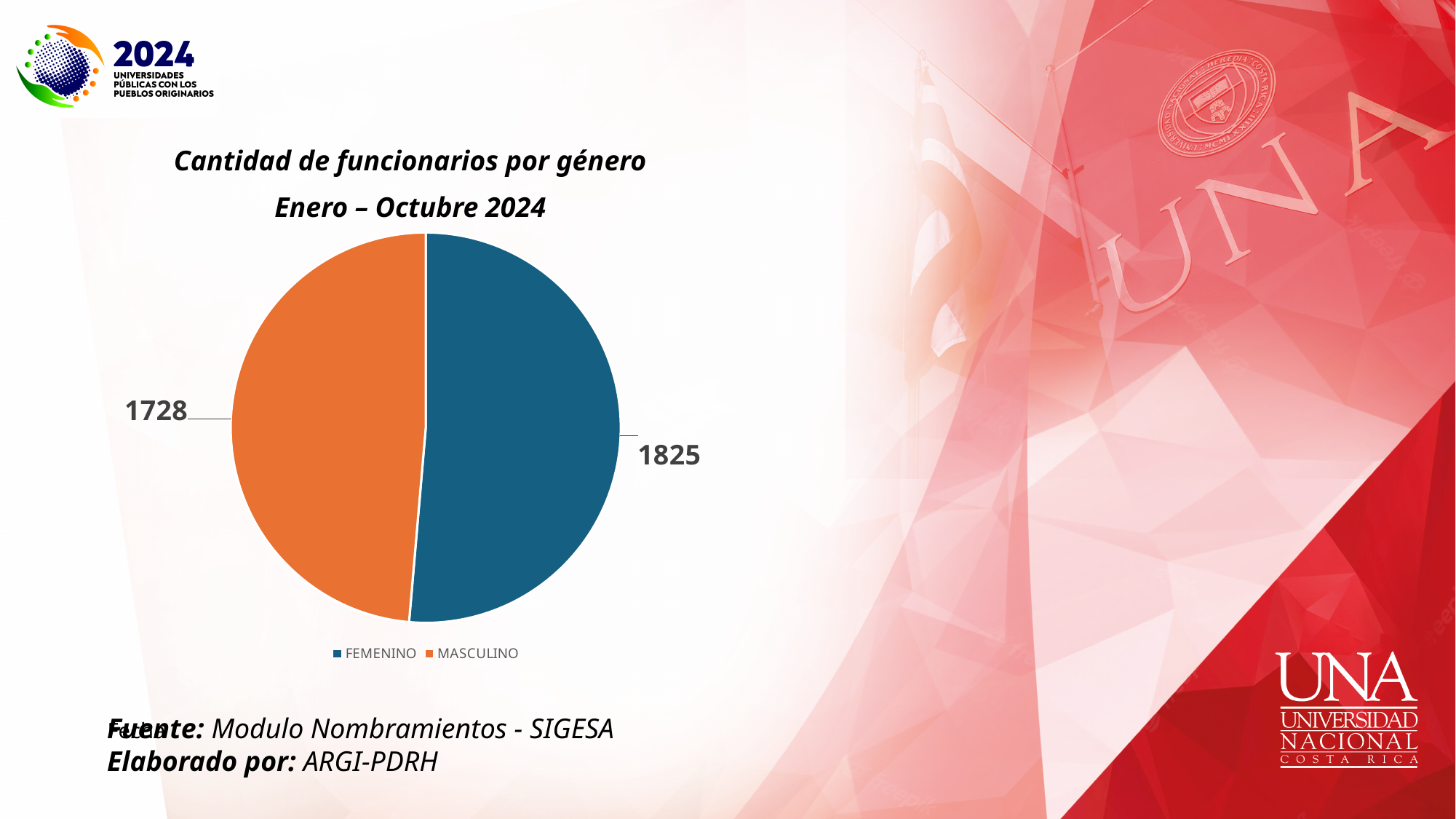
Which category has the largest slice in the pie chart? FEMENINO How many entries does the legend of the pie chart list? 2 What colour is the FEMENINO slice in the pie chart? Blue Which category has the smallest slice in the pie chart? MASCULINO What is the total of the two values shown in the pie chart? 3553 What is the value for MASCULINO in the pie chart? 1728 Which is larger, the value for FEMENINO or the value for MASCULINO? FEMENINO How many slices does the pie chart have? 2 What is the difference between the FEMENINO and MASCULINO values? 97 What is the title of the chart? Cantidad de funcionarios por género Enero – Octubre 2024 What is the value for FEMENINO in the pie chart? 1825 What kind of chart is shown on the slide? Pie chart